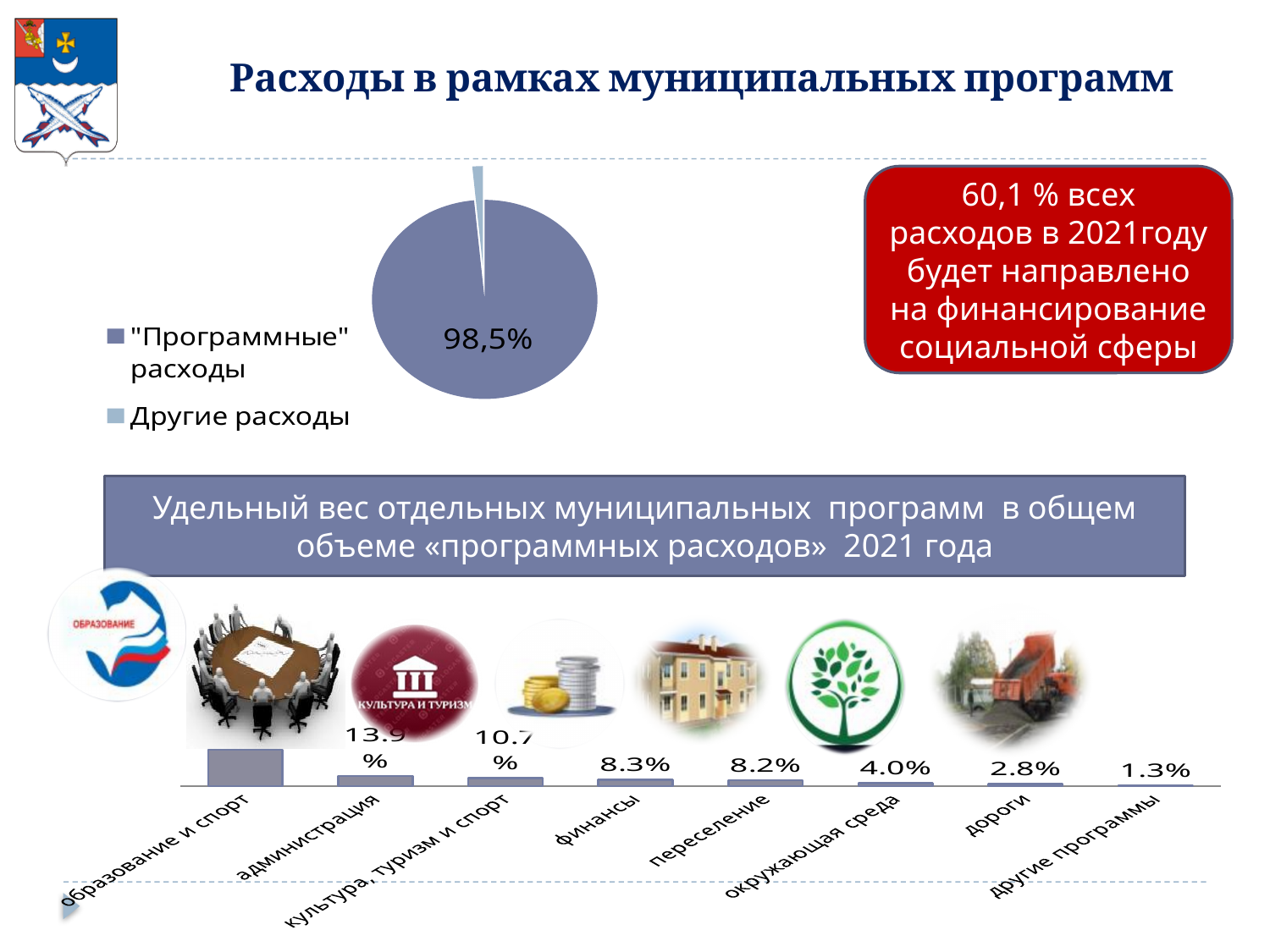
How many categories are shown on the x axis of the bottom bar chart? 8 In the bottom bar chart, what is the difference between the values for администрация and культура, туризм и спорт? 3.2% In the bottom bar chart, what is the value for дороги? 2.8% What kind of chart is the chart at the top of the slide? pie chart In the pie chart at the top of the slide, what share is shown for "Программные" расходы? 98,5% In the bottom bar chart, what is the value for администрация? 13.9% In the bottom bar chart, which category has the lowest value? другие программы In the bottom bar chart, what is the value for финансы? 8.3% How many entries does the legend of the pie chart at the top of the slide list? 2 What kind of chart is the chart at the bottom of the slide (Удельный вес отдельных муниципальных программ)? bar chart In the pie chart at the top of the slide, which slice is larger: "Программные" расходы or Другие расходы? "Программные" расходы In the bottom bar chart, which category has the tallest bar? образование и спорт